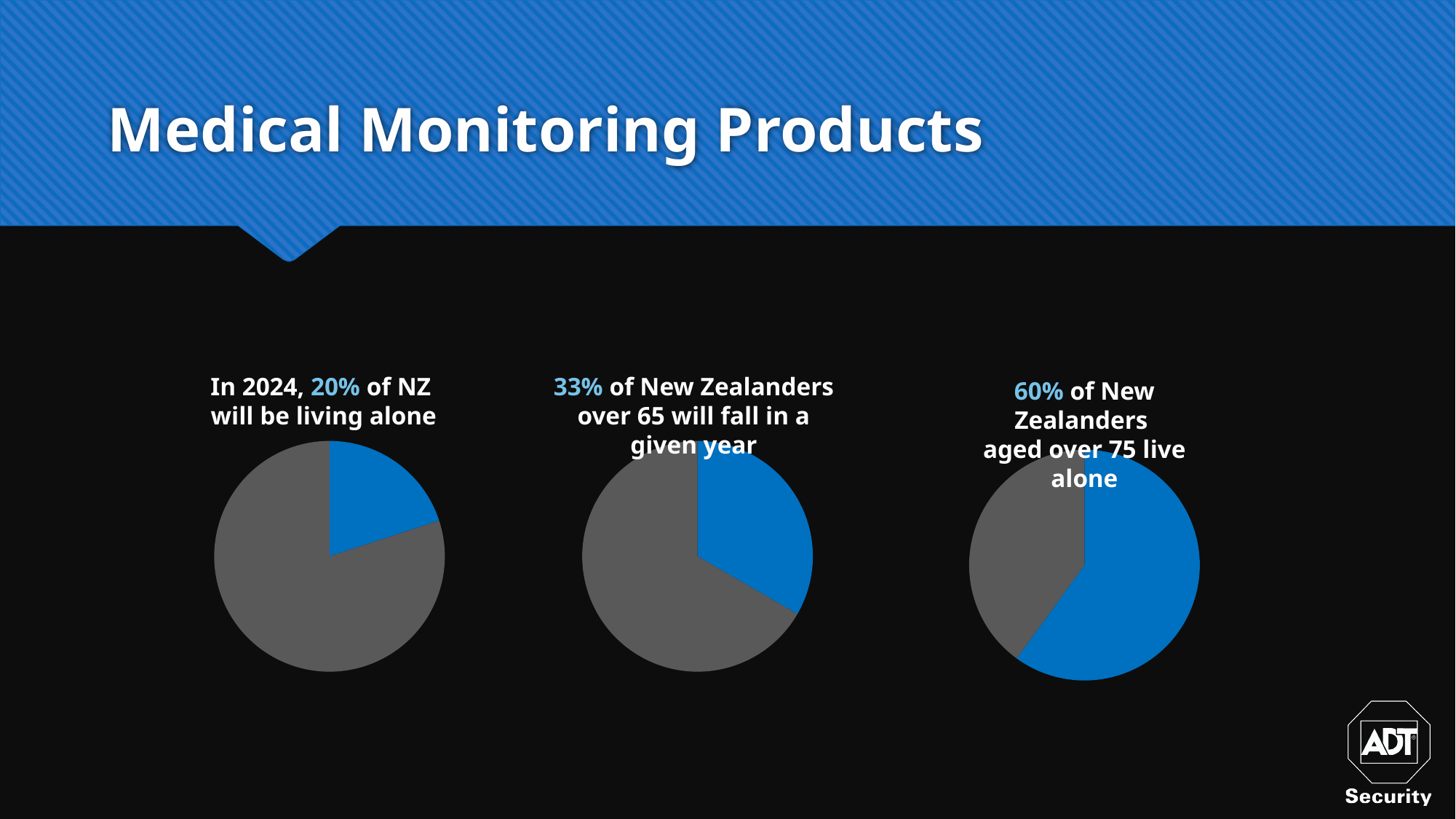
Is the blue slice larger in the left pie chart or the middle pie chart? the middle pie chart What is the difference between the blue share in the right pie chart and the blue share in the left pie chart? 40% In the left pie chart (NZ living alone in 2024), what share does the blue slice represent? 20% What is the title of the slide? Medical Monitoring Products Which of the three pie charts has the largest blue slice? the right pie chart (60% of New Zealanders aged over 75 live alone) How many slices does each pie chart on the slide have? 2 How many pie charts are shown on the slide? 3 In the right pie chart (New Zealanders aged over 75 living alone), what share does the blue slice represent? 60% In the right pie chart, does the blue slice cover more or less than half of the pie? more What kind of chart is the left chart on the slide? pie chart In the middle pie chart (New Zealanders over 65 who will fall in a given year), what share does the blue slice represent? 33% Which of the three pie charts has the smallest blue slice? the left pie chart (20% of NZ will be living alone in 2024)